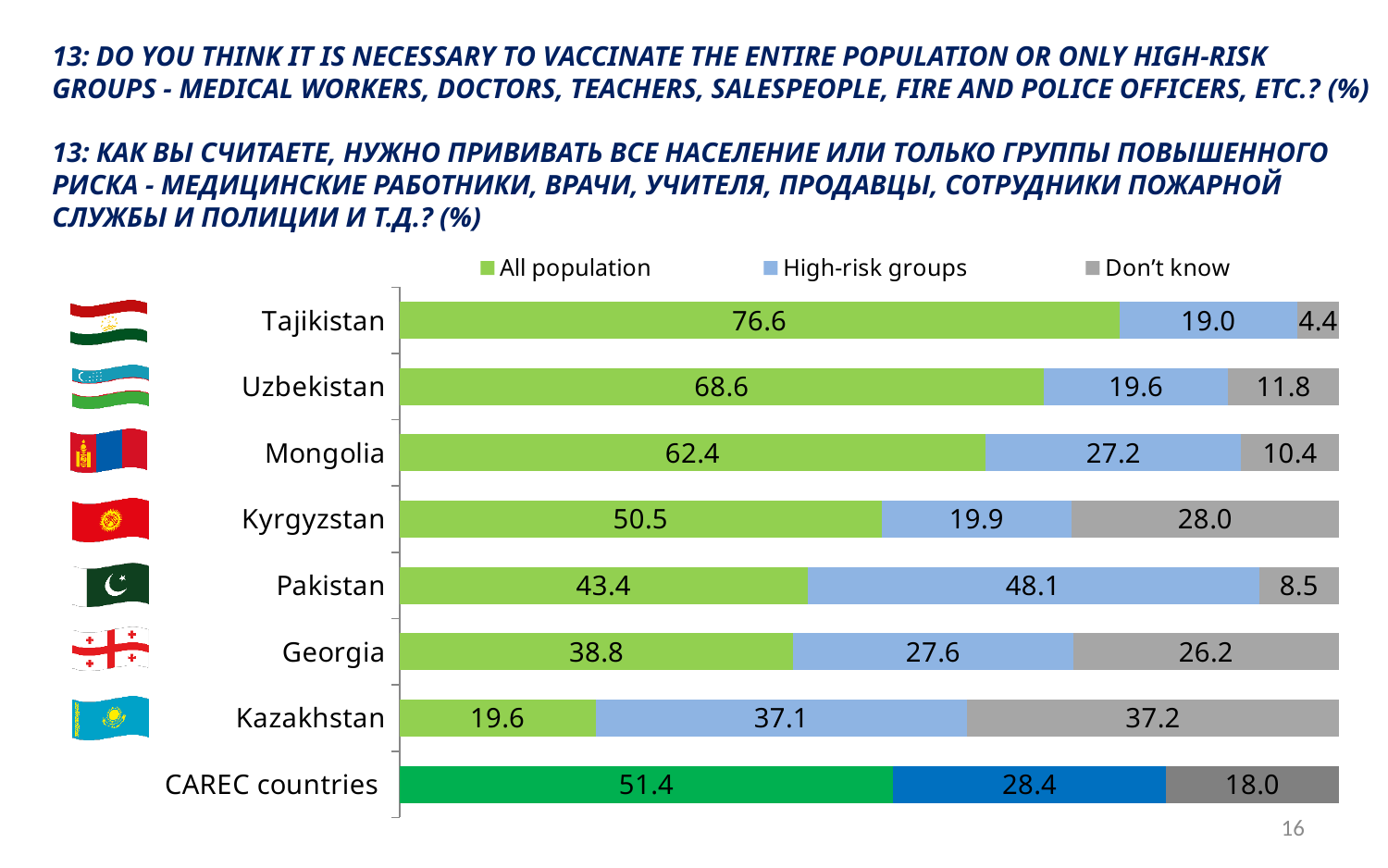
How many categories (rows) are shown in the chart? 8 Which country has the lowest 'All population' value? Kazakhstan What is the 'High-risk groups' value for Pakistan? 48.1 What kind of chart is shown on the slide? Stacked bar chart Which country has the highest 'Don't know' value? Kazakhstan Which country has the highest 'All population' value? Tajikistan What percentage of respondents in Tajikistan said all population should be vaccinated? 76.6 How many series does the legend list? 3 Which is larger for Georgia: the 'High-risk groups' value or the 'Don't know' value? High-risk groups What is the difference between the 'All population' values for Uzbekistan and Mongolia? 6.2 What is the 'Don't know' value for Kazakhstan? 37.2 What is the 'All population' value for CAREC countries? 51.4